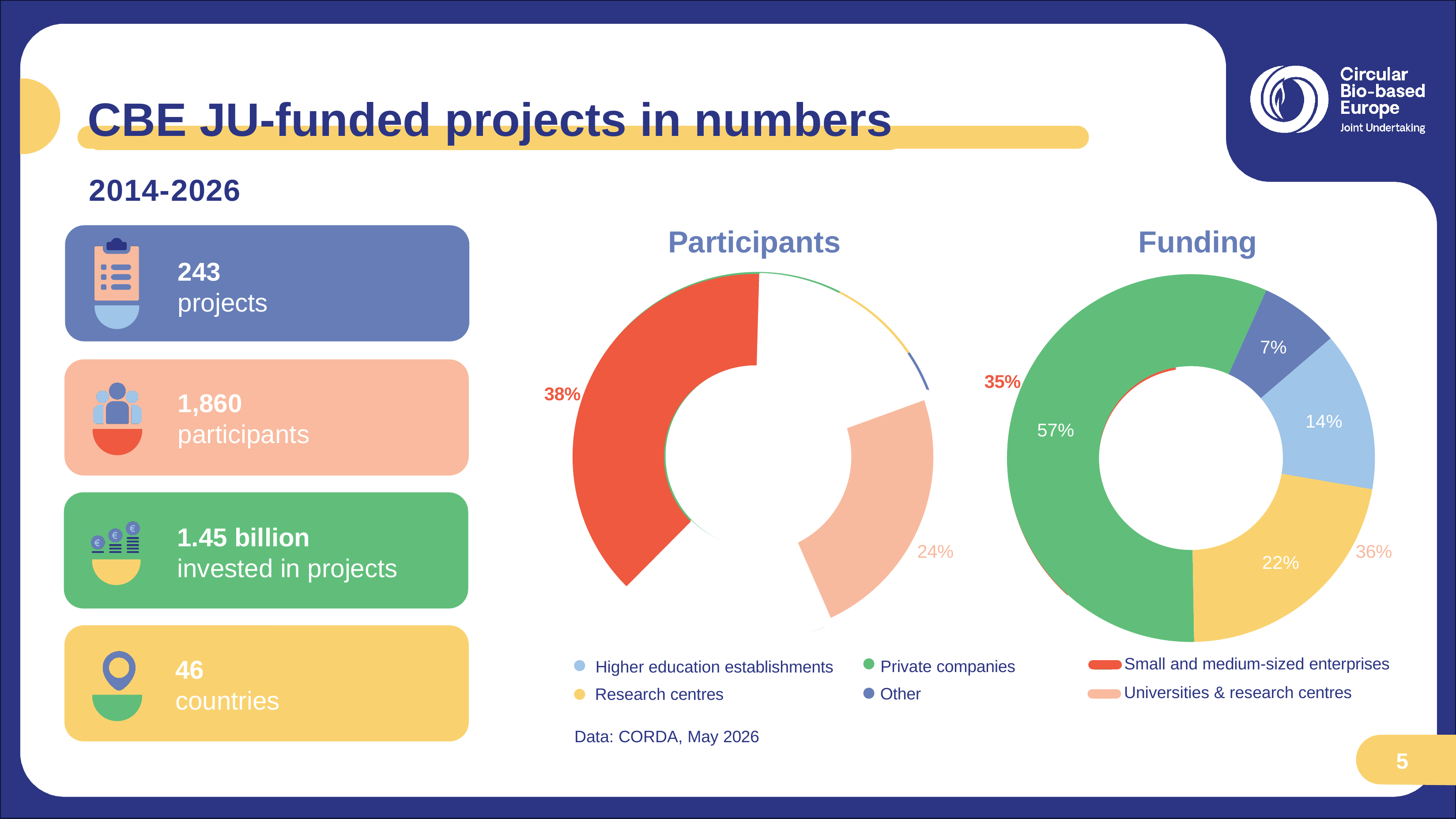
What kind of chart is the Funding chart? Doughnut chart In the Participants chart, which is larger: Small and medium-sized enterprises or Universities & research centres? Small and medium-sized enterprises In the Participants chart, what percentage is shown for Small and medium-sized enterprises? 38% How many entries does the legend below the charts list? 6 In the Participants chart, what is the difference between the Small and medium-sized enterprises share and the Universities & research centres share? 14% In the Funding chart, which category has the smallest labelled share? Other In the Funding chart, what percentage is shown for Higher education establishments? 14% In the Funding chart, what percentage is shown for Research centres? 22% In the Funding chart, what percentage is shown for Other? 7% In the Funding chart, which category has the largest labelled share? Private companies In the Funding chart, what percentage is shown for Private companies? 57% In the Participants chart, what percentage is shown for Universities & research centres? 24%